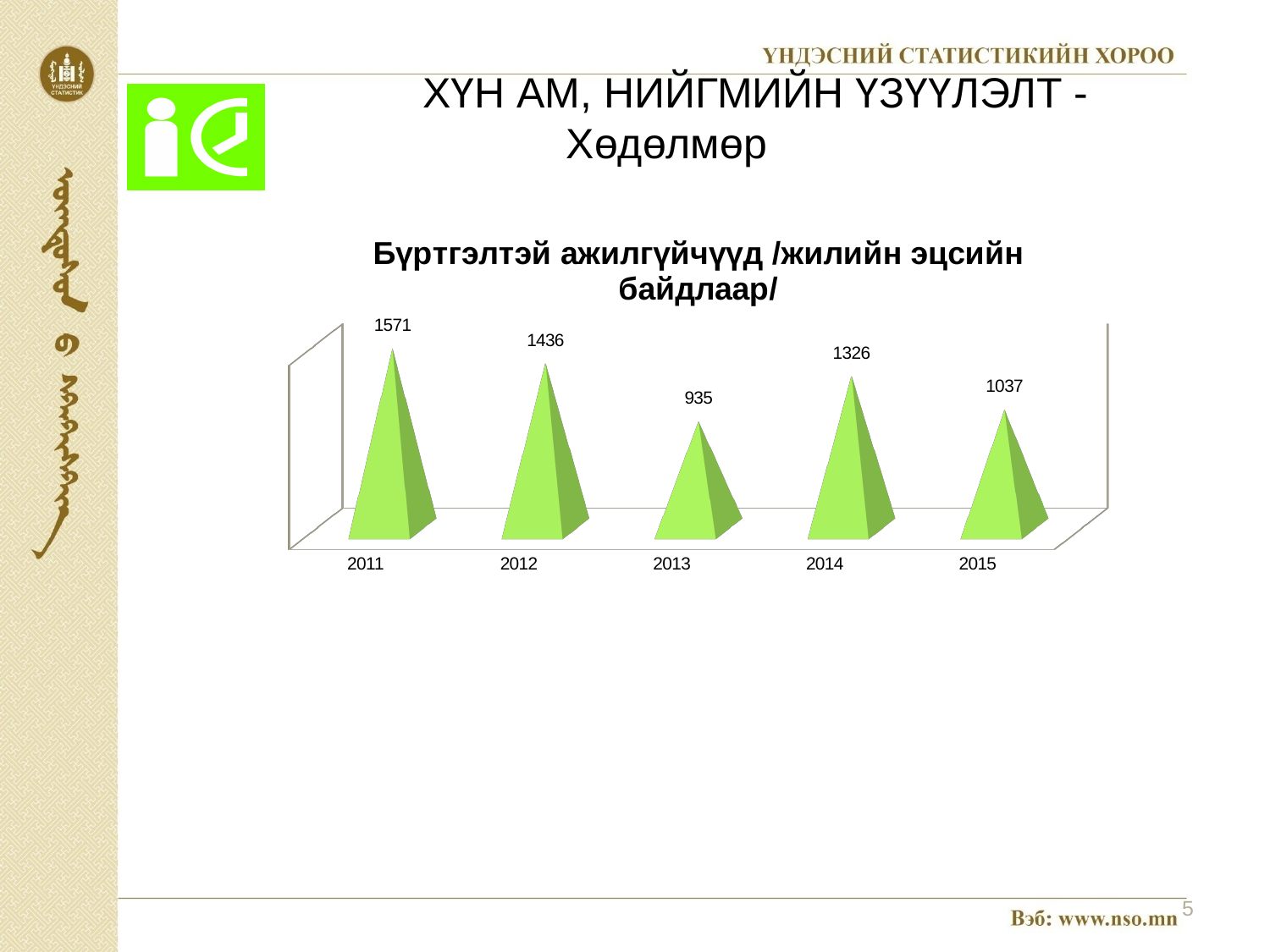
How many years are shown on the chart? 5 Which is larger, the value for 2012 or the value for 2014? 2012 What kind of chart is this? bar chart What is the value for 2013? 935 Which year has the highest value? 2011 What is the difference between the values for 2011 and 2012? 135 What is the title of the chart? Бүртгэлтэй ажилгүйчүүд /жилийн эцсийн байдлаар/ What is the value for 2015? 1037 Which year has the lowest value? 2013 What is the value for 2011? 1571 Do the values rise or fall from 2011 to 2013? fall What is the difference between the values for 2014 and 2015? 289